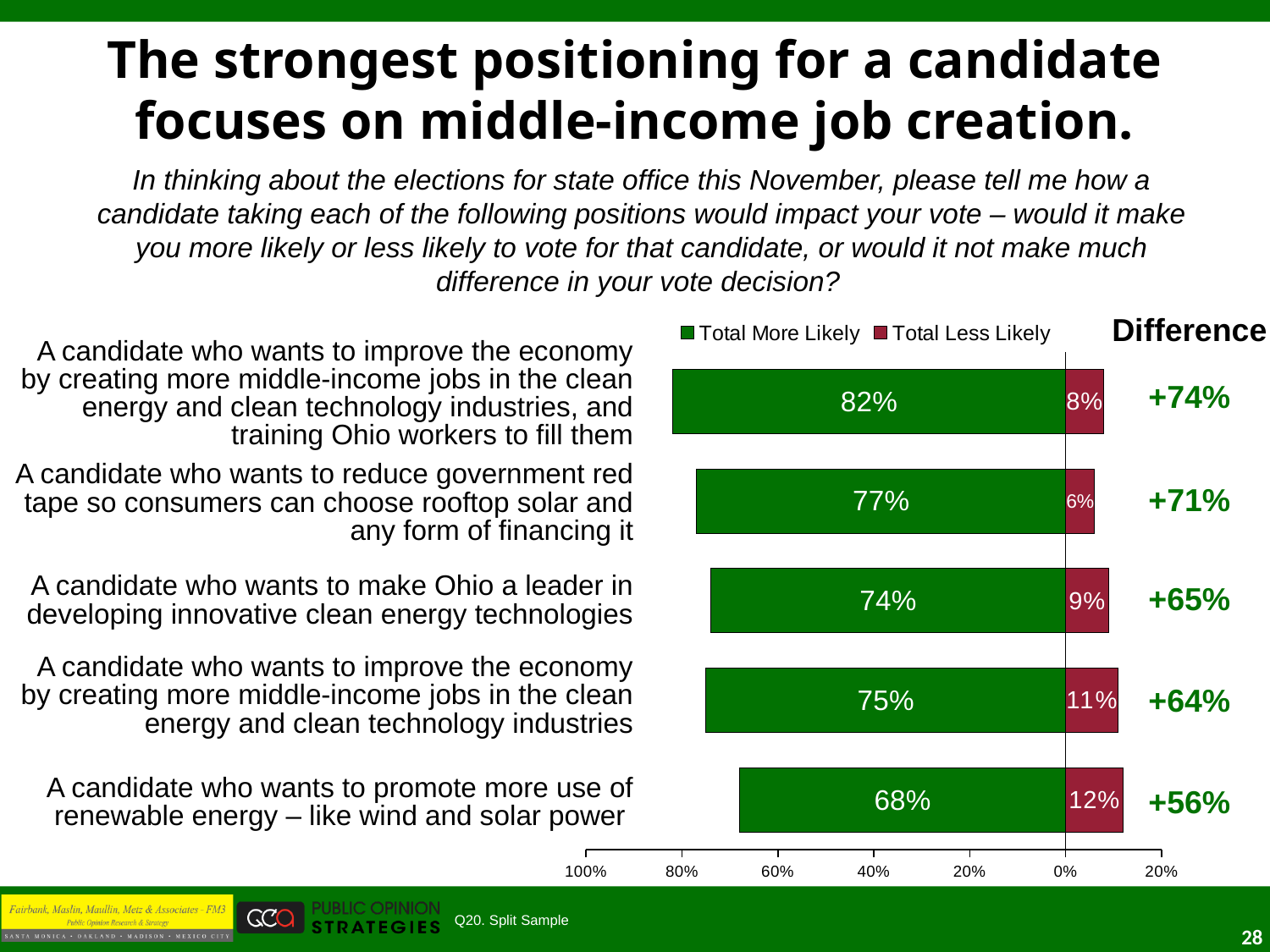
How many candidate positions are shown in the chart? 5 Which position has the lowest Total More Likely percentage? A candidate who wants to promote more use of renewable energy – like wind and solar power What is the Difference shown for the position about making Ohio a leader in developing innovative clean energy technologies? +65% What percentage of respondents said they would be more likely to vote for a candidate who wants to promote more use of renewable energy like wind and solar power? 68% Which position has the highest Total More Likely percentage? A candidate who wants to improve the economy by creating more middle-income jobs in the clean energy and clean technology industries, and training Ohio workers to fill them How many series does the legend list? 2 How much higher is the Total More Likely value for the top position (82%) than for the renewable energy position (68%)? 14 percentage points Which is larger: the Total Less Likely value for the rooftop solar position or for the renewable energy position? Renewable energy position (12%) What is the Total More Likely value for a candidate who wants to make Ohio a leader in developing innovative clean energy technologies? 74% What type of chart is shown on the slide? Bar chart Which position has the highest Total Less Likely percentage? A candidate who wants to promote more use of renewable energy – like wind and solar power What is the Total Less Likely value for a candidate who wants to reduce government red tape so consumers can choose rooftop solar? 6%